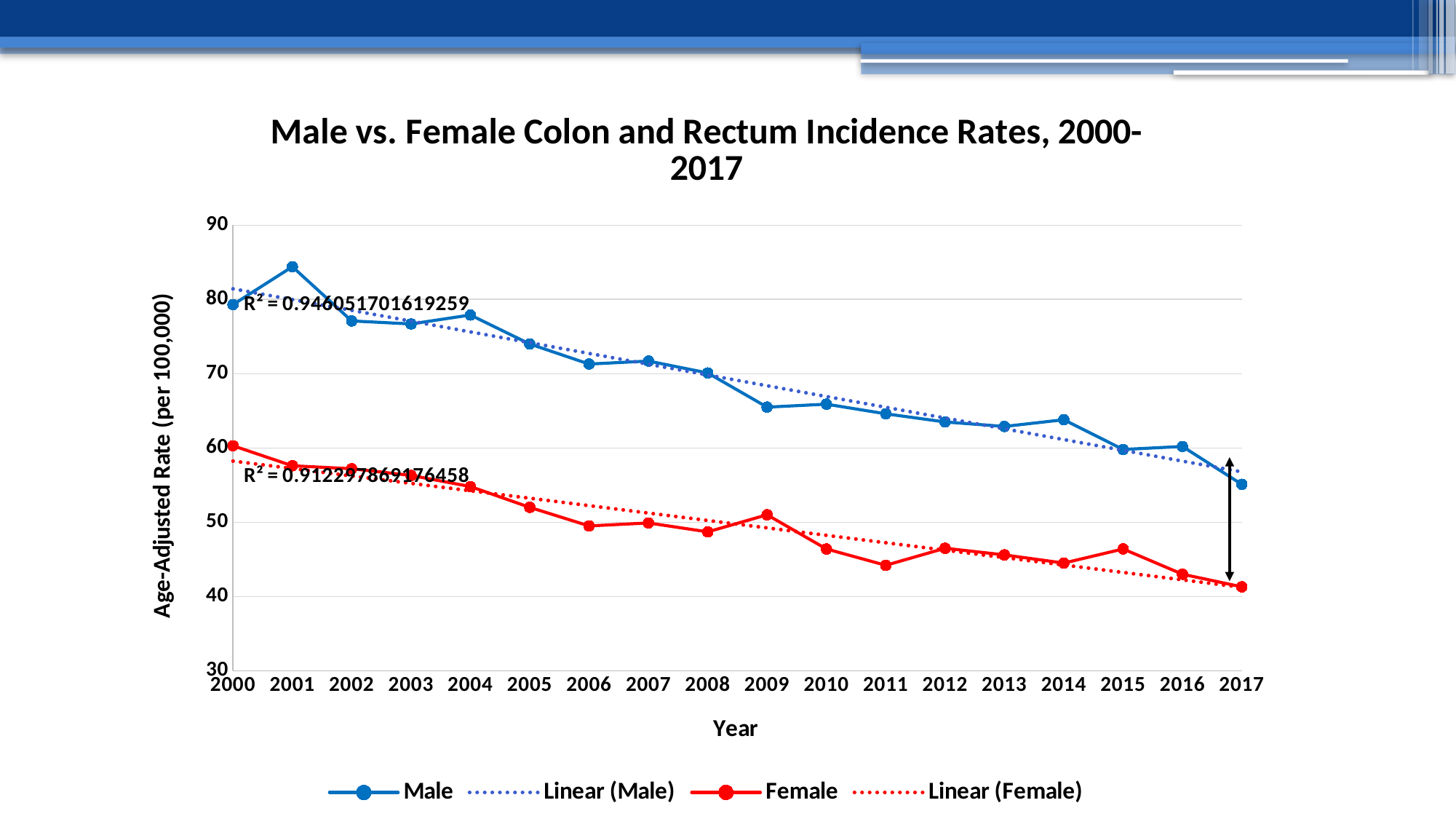
In which year is the Female incidence rate highest? 2000 How many series does the legend list? 4 In which year is the Male incidence rate highest? 2001 Is the Male value for 2001 greater or less than 80? greater Which series has the larger value in 2010, Male or Female? Male What is the R² value shown for the Male linear trendline? 0.946051701619259 In which year is the Female incidence rate lowest? 2017 In which year is the Male incidence rate lowest? 2017 Is the Female value for 2017 greater or less than 50? less Do the Male incidence rates generally rise or fall from 2000 to 2017? fall How many years are plotted along the x axis? 18 What kind of chart is shown on the slide? line chart